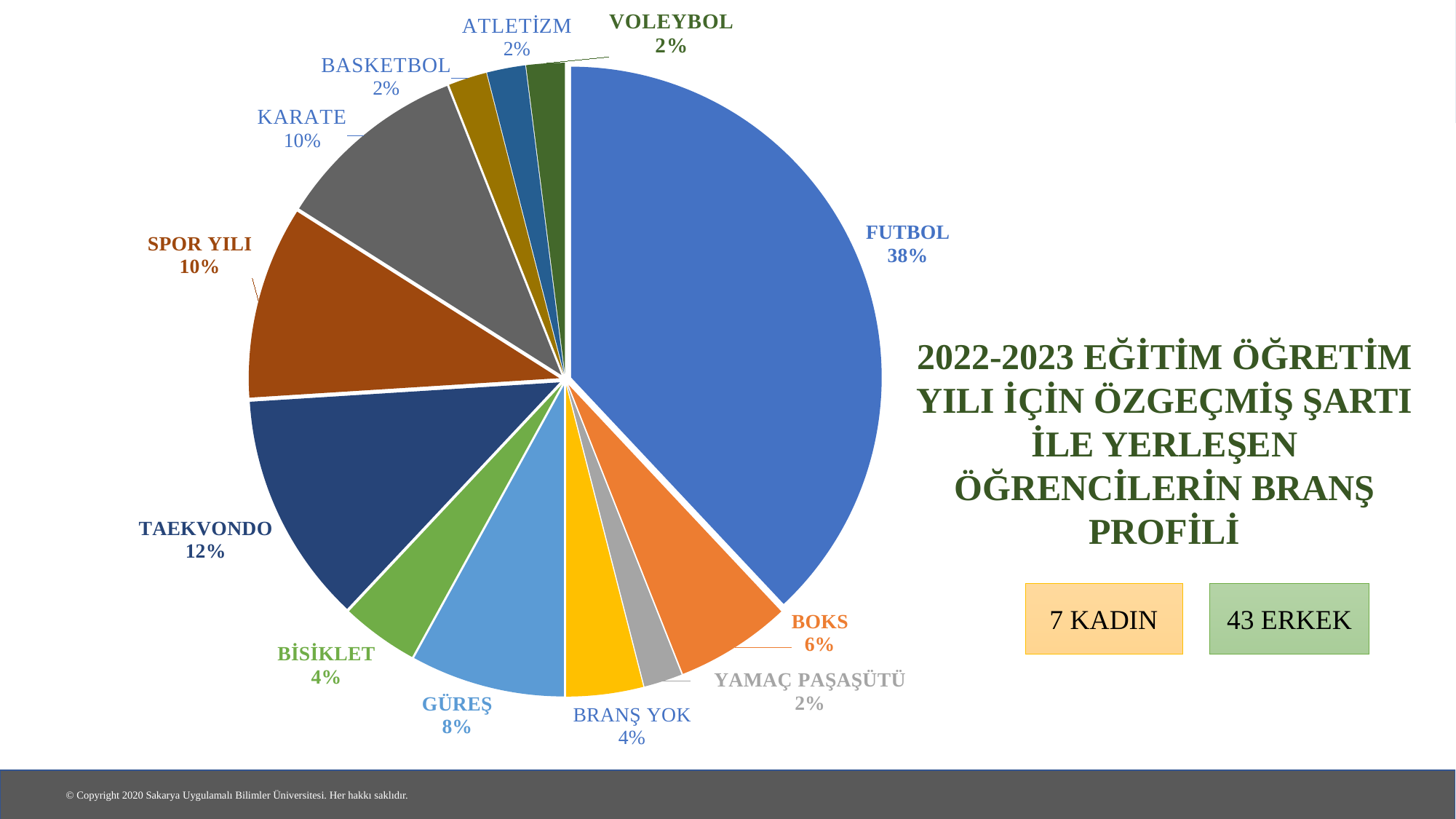
What type of chart is shown on the slide? pie chart Which is larger, the share for KARATE or the share for GÜREŞ? KARATE What percentage is shown for BİSİKLET? 4% What is the difference in percentage points between FUTBOL and TAEKVONDO? 26 What percentage is shown for GÜREŞ? 8% What is the combined share of SPOR YILI and KARATE? 20% How many categories are shown in the pie chart? 12 What share of the pie does FUTBOL have? 38% What percentage is shown for TAEKVONDO? 12% What percentage is shown for BOKS? 6% What is the title of the chart on the slide? 2022-2023 EĞİTİM ÖĞRETİM YILI İÇİN ÖZGEÇMİŞ ŞARTI İLE YERLEŞEN ÖĞRENCİLERİN BRANŞ PROFİLİ Which category has the largest slice of the pie? FUTBOL